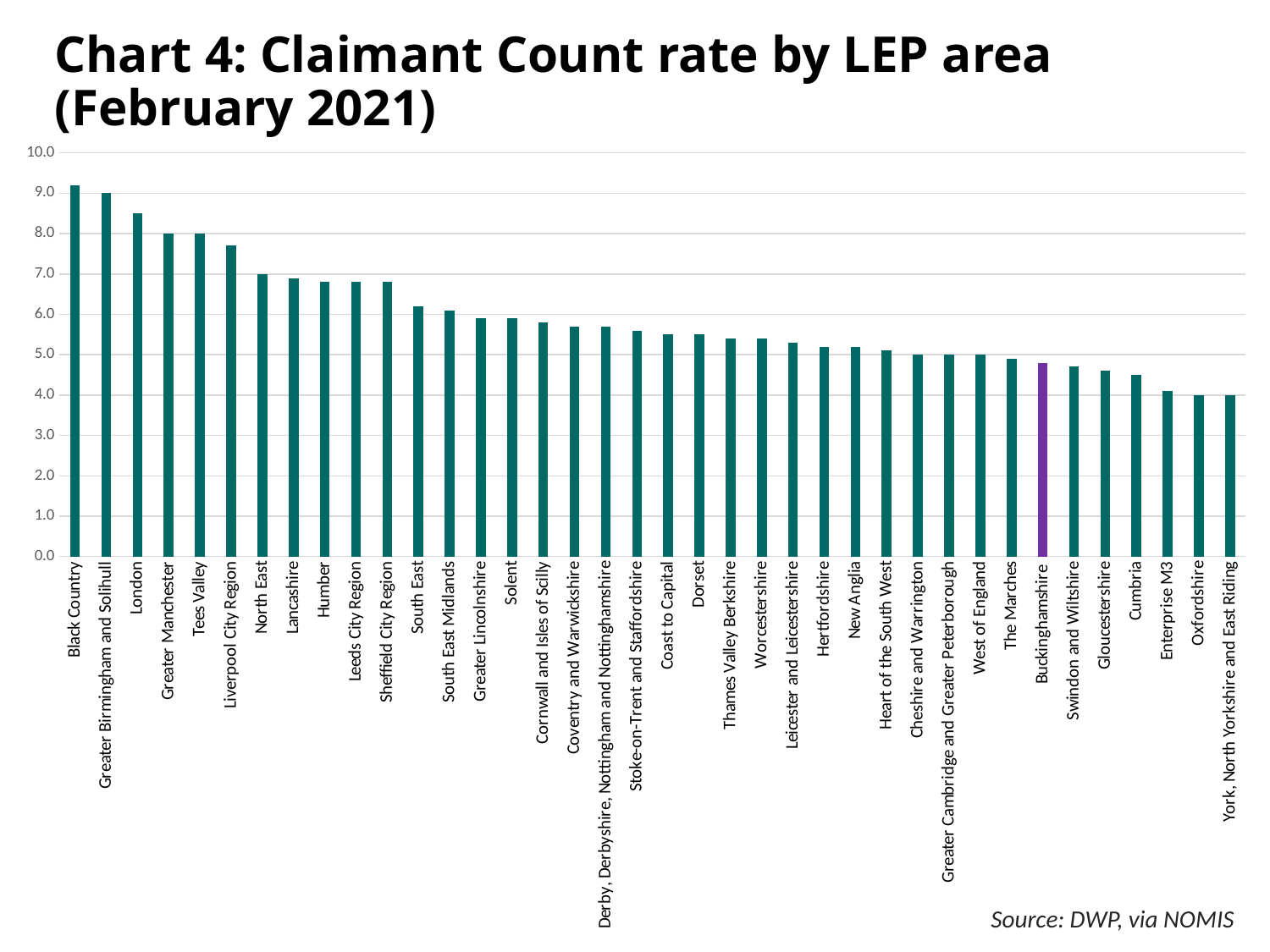
Which LEP area has the highest Claimant Count rate? Black Country Is the value for Liverpool City Region greater or less than 7.0? greater How many LEP areas are plotted on the chart? 38 Which has the higher Claimant Count rate, Tees Valley or Cumbria? Tees Valley Is the value for Cumbria greater or less than 5.0? less What kind of chart is shown on the slide? Bar chart Is the value for Enterprise M3 greater or less than 5.0? less Which LEP area's bar is highlighted in purple? Buckinghamshire Do the values rise or fall moving from left to right along the x axis? Fall Which has the higher Claimant Count rate, London or Greater Manchester? London